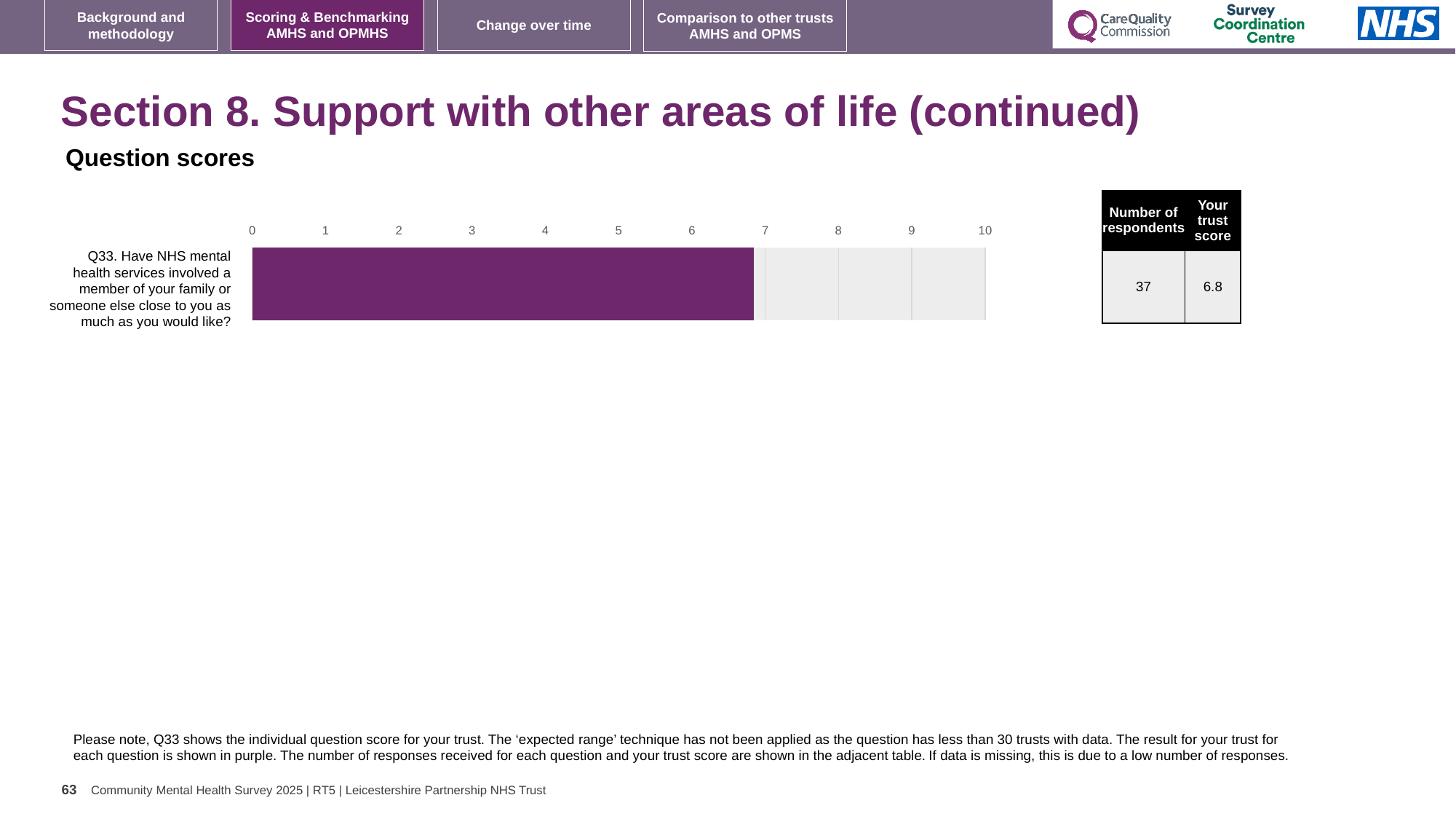
Is the bar for Q33 greater or less than 7 on the axis? less What is the maximum value shown on the chart's axis? 10 Is the bar for Q33 greater or less than 5 on the axis? greater Which question number is plotted in the chart? Q33 What colour is the bar for Q33? purple Is the bar for Q33 greater or less than 6 on the axis? greater How many questions (bars) are plotted in the chart? 1 What is the trust score for Q33 shown in the table next to the chart? 6.8 What kind of chart is shown on the slide? bar chart How many respondents answered Q33 according to the table beside the chart? 37